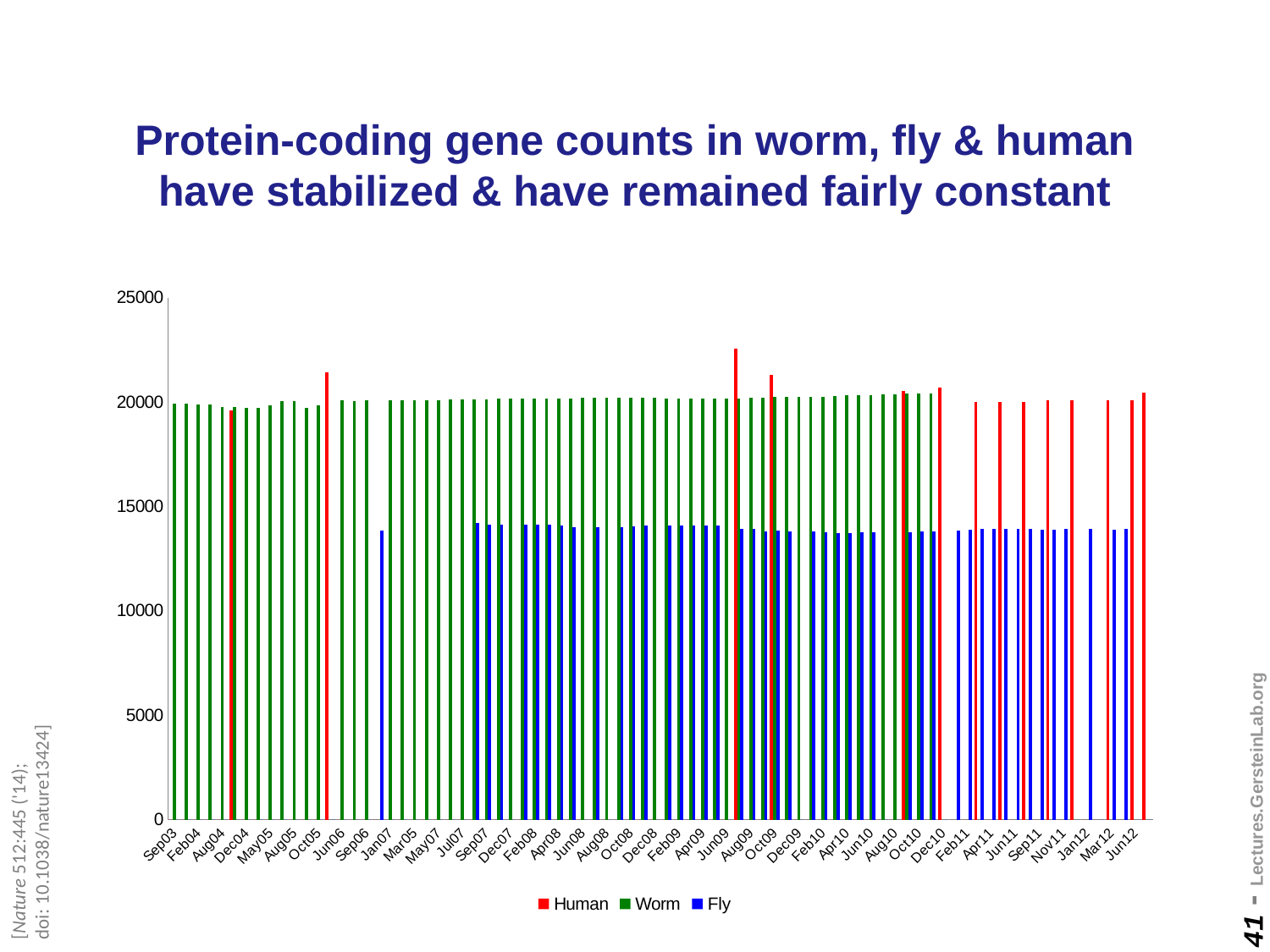
Is the Fly value for Jan07 greater or less than 15000? less What is the highest value shown on the y axis? 25000 Which colour represents the Fly series? blue Which series are listed in the legend? Human, Worm, Fly At Jan07, which is larger, the Worm value or the Fly value? Worm Which series has the lowest gene counts throughout the chart? Fly What kind of chart is shown on the slide? bar chart How many series does the legend list? 3